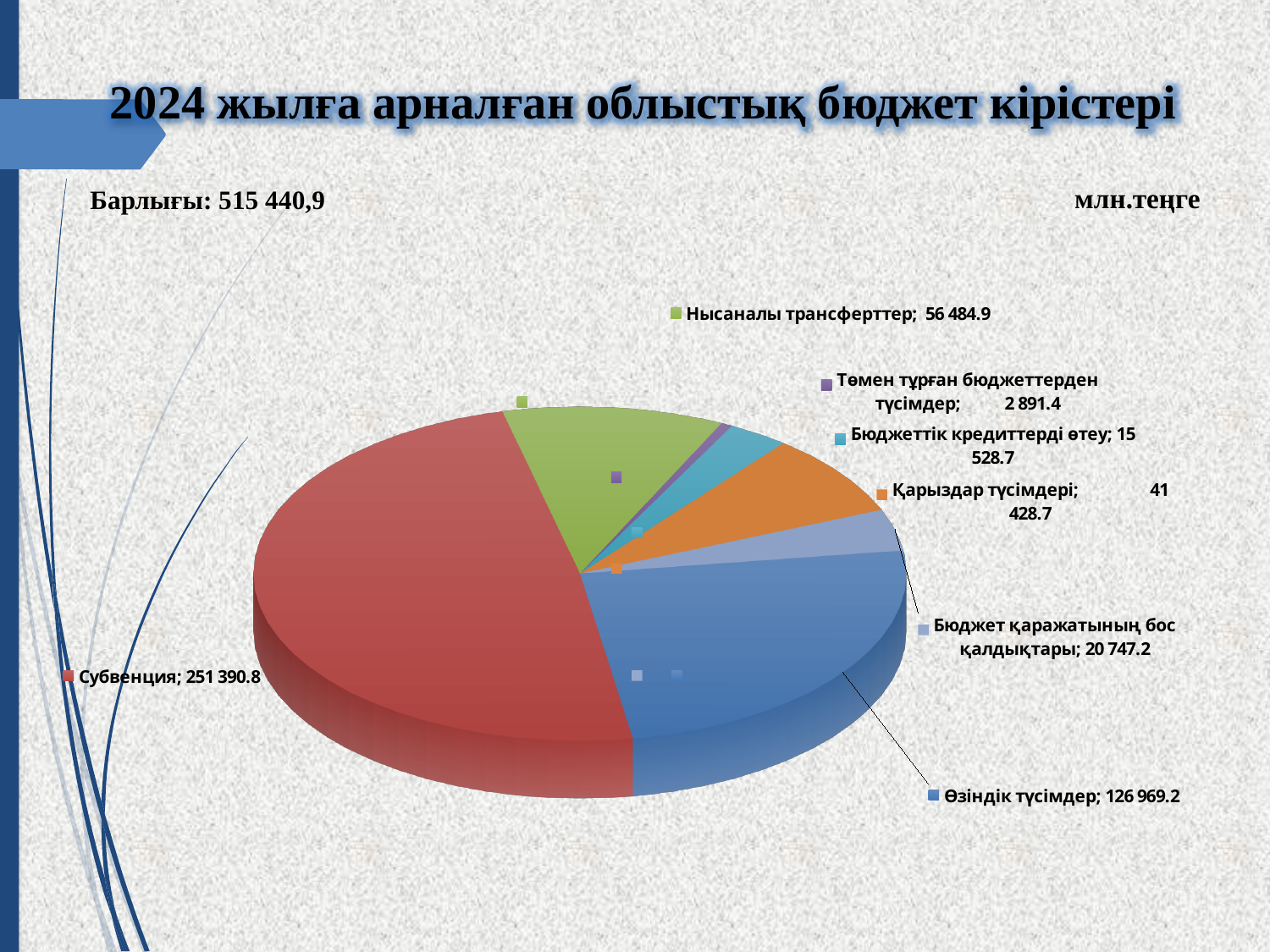
What is the value for Өзіндік түсімдер? 126 969.2 What is the value for Бюджет қаражатының бос қалдықтары? 20 747.2 Which category has the largest slice of the pie? Субвенция What is the value for Төмен тұрған бюджеттерден түсімдер? 2 891.4 Which is larger, Қарыздар түсімдері or Бюджеттік кредиттерді өтеу? Қарыздар түсімдері How many categories are shown in the pie chart? 7 What kind of chart is shown on the slide? Pie chart What is the value for Нысаналы трансферттер? 56 484.9 Which category has the smallest slice of the pie? Төмен тұрған бюджеттерден түсімдер What is the value for Субвенция? 251 390.8 What is the difference between the values for Нысаналы трансферттер and Қарыздар түсімдері? 15 056.2 What is the difference between the values for Субвенция and Өзіндік түсімдер? 124 421.6